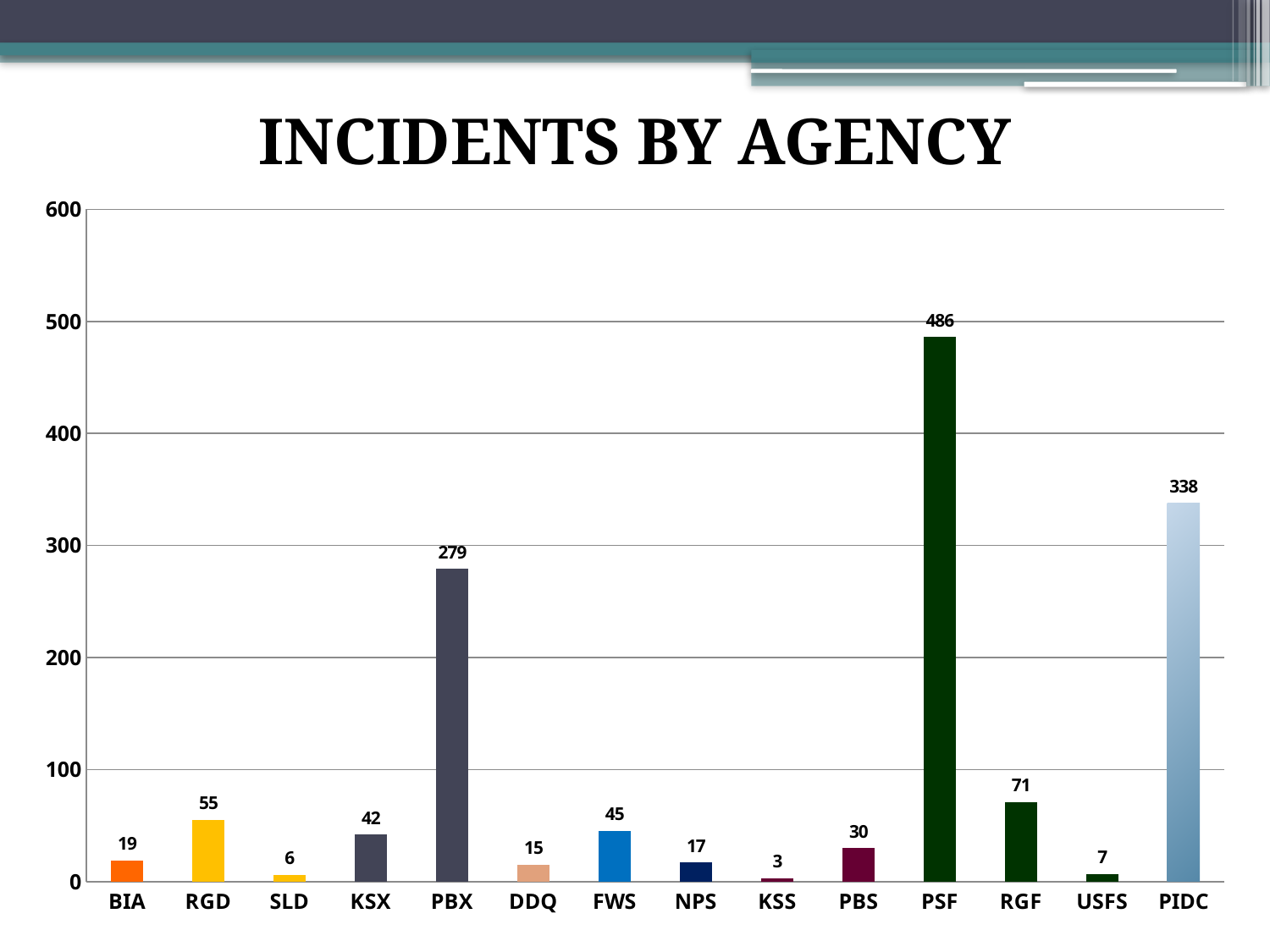
What kind of chart is shown on the slide? Bar chart How many agencies are shown on the x axis? 14 What is the difference in incidents between PSF and PIDC? 148 Is the value for PIDC greater or less than 300? greater What is the number of incidents for PBX? 279 Which agency has the highest number of incidents? PSF What is the number of incidents for PSF? 486 What is the difference in incidents between RGF and USFS? 64 What is the number of incidents for KSS? 3 What is the title of the chart? INCIDENTS BY AGENCY Which agency has the lowest number of incidents? KSS Which agency has more incidents, RGD or FWS? RGD